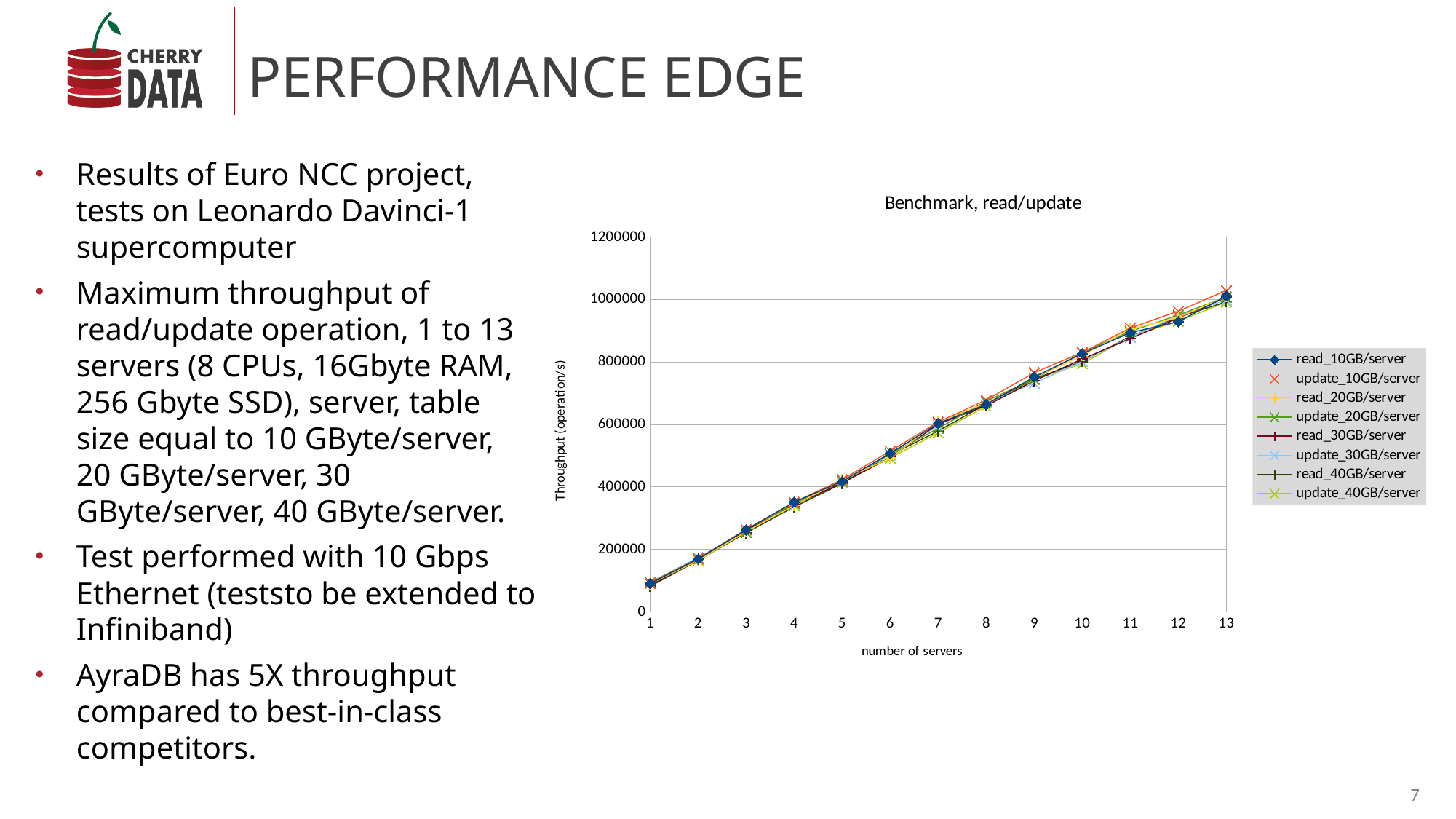
Is the throughput for update_40GB/server at 10 servers greater or less than 600000? greater How many values of 'number of servers' are plotted along the x axis? 13 How many series does the legend of the chart list? 8 Is the throughput for read_10GB/server at 13 servers greater or less than 800000? greater What kind of chart is shown on the slide? line chart Is the throughput for update_10GB/server at 1 server greater or less than 200000? less Does throughput rise or fall as the number of servers increases from 1 to 13? rises What is the label of the y axis of the chart? Throughput (operation/s) At which number of servers is the throughput highest? 13 What is the title of the chart? Benchmark, read/update